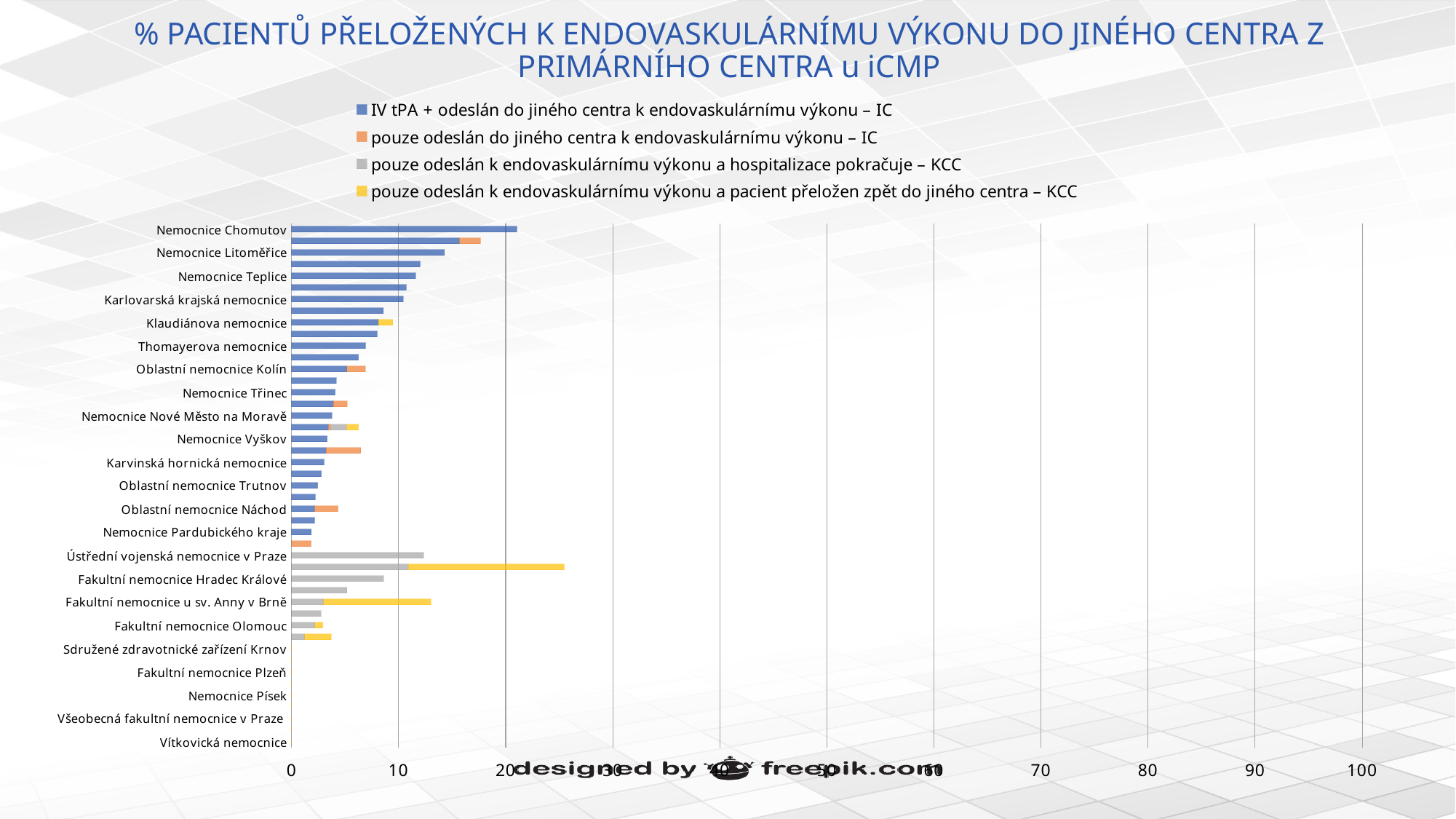
Which has the longer bar, Nemocnice Litoměřice or Klaudiánova nemocnice? Nemocnice Litoměřice Is the value for Klaudiánova nemocnice greater or less than 10? less Is the total bar for Ústřední vojenská nemocnice v Praze greater or less than 10? greater Which has the longer bar, Nemocnice Teplice or Thomayerova nemocnice? Nemocnice Teplice What kind of chart is shown on the slide? bar chart Is the value for Nemocnice Litoměřice greater or less than 20? less Which colour represents the series 'IV tPA + odeslán do jiného centra k endovaskulárnímu výkonu – IC'? blue How many series does the legend list? 4 What is the highest value shown on the horizontal axis? 100